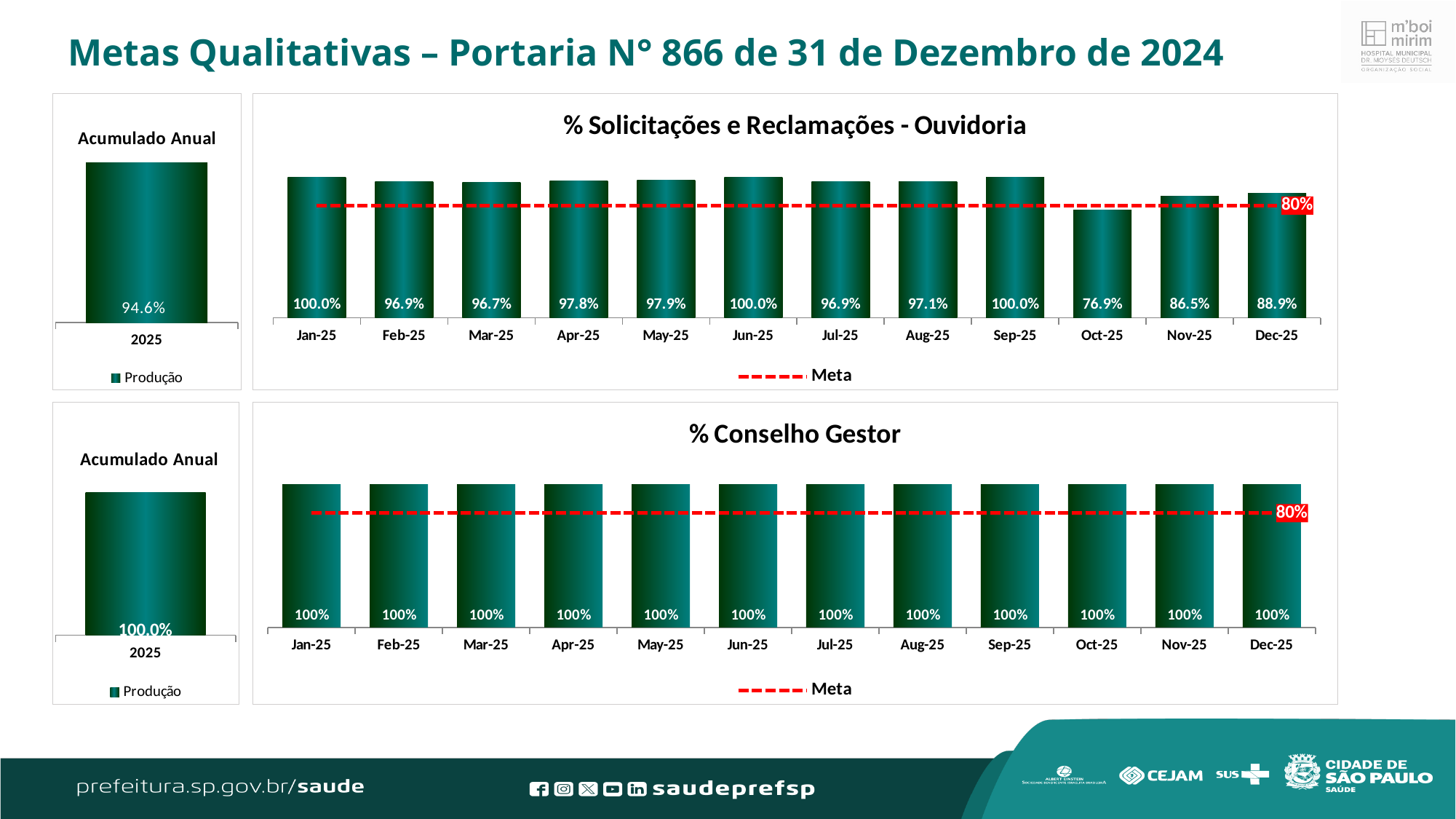
What type of chart is the '% Conselho Gestor' chart? Bar chart In the bottom-left 'Acumulado Anual' chart, what is the value for 2025? 100.0% In the '% Conselho Gestor' chart, is the value for Mar-25 greater or less than 80%? greater In the '% Solicitações e Reclamações - Ouvidoria' chart, which month has the lowest value? Oct-25 In the '% Solicitações e Reclamações - Ouvidoria' chart, what is the value for Feb-25? 96.9% In the '% Conselho Gestor' chart, what is the value for Jul-25? 100% In the top-left 'Acumulado Anual' chart, what is the value for 2025? 94.6% In the '% Solicitações e Reclamações - Ouvidoria' chart, what is the value for Oct-25? 76.9% In the '% Solicitações e Reclamações - Ouvidoria' chart, how many months are plotted? 12 In the '% Solicitações e Reclamações - Ouvidoria' chart, which is larger, the value for Dec-25 or the value for Nov-25? Dec-25 In the '% Solicitações e Reclamações - Ouvidoria' chart, what value does the dashed Meta line mark? 80% In the '% Solicitações e Reclamações - Ouvidoria' chart, what is the difference between the values for Nov-25 and Oct-25? 9.6%